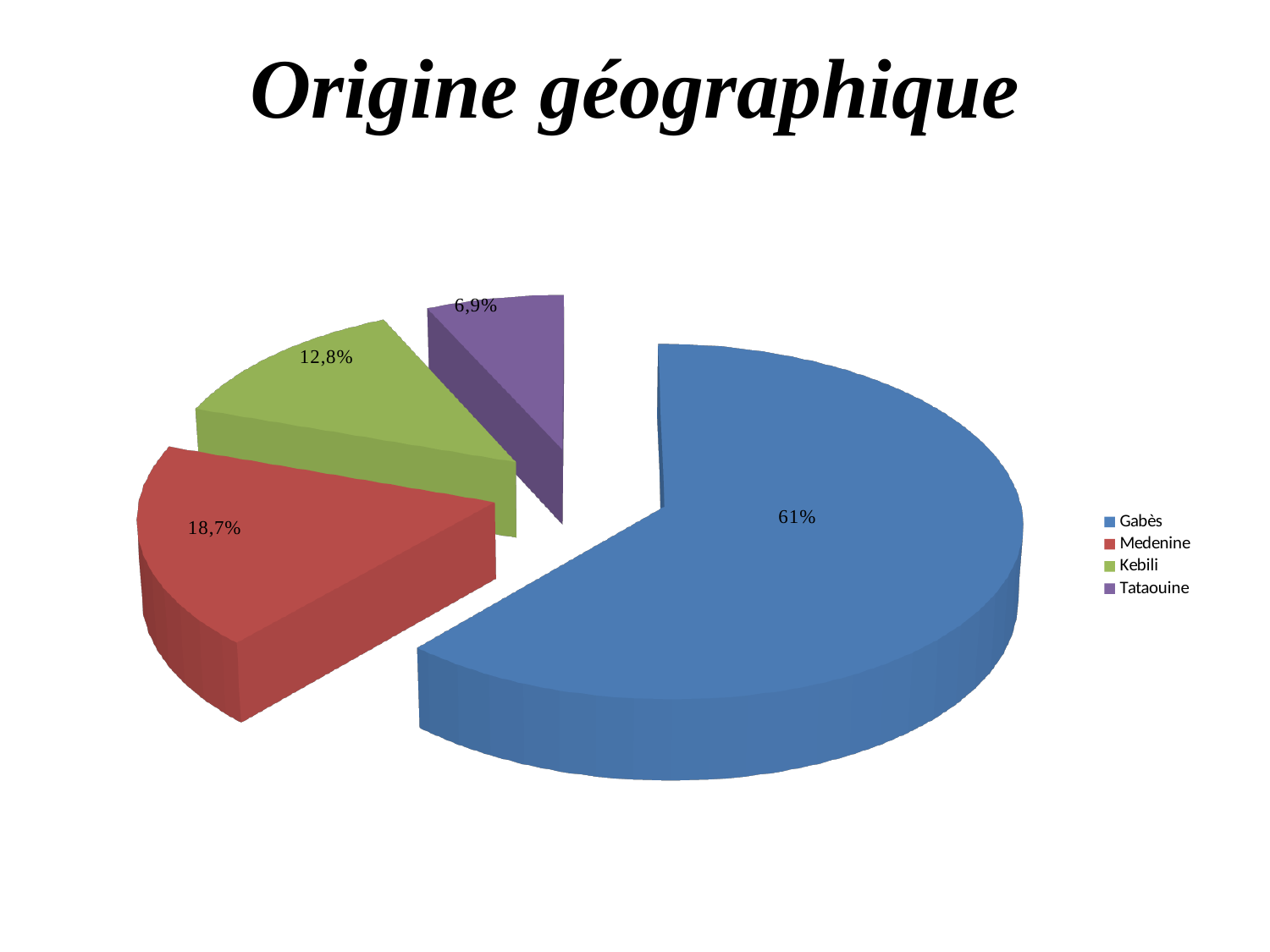
Which category has the smallest slice of the pie? Tataouine What is the value shown for Tataouine? 6,9% What is the title of the slide? Origine géographique What kind of chart is shown on the slide? Pie chart What is the difference between the values for Medenine and Kebili? 5,9% How many categories are shown in the pie chart? 4 Which category has the largest slice of the pie? Gabès What is the value shown for Medenine? 18,7% What share of the pie does Gabès represent? 61% What is the difference between the values for Kebili and Tataouine? 5,9% Which is larger, the slice for Medenine or the slice for Kebili? Medenine What is the value shown for Kebili? 12,8%